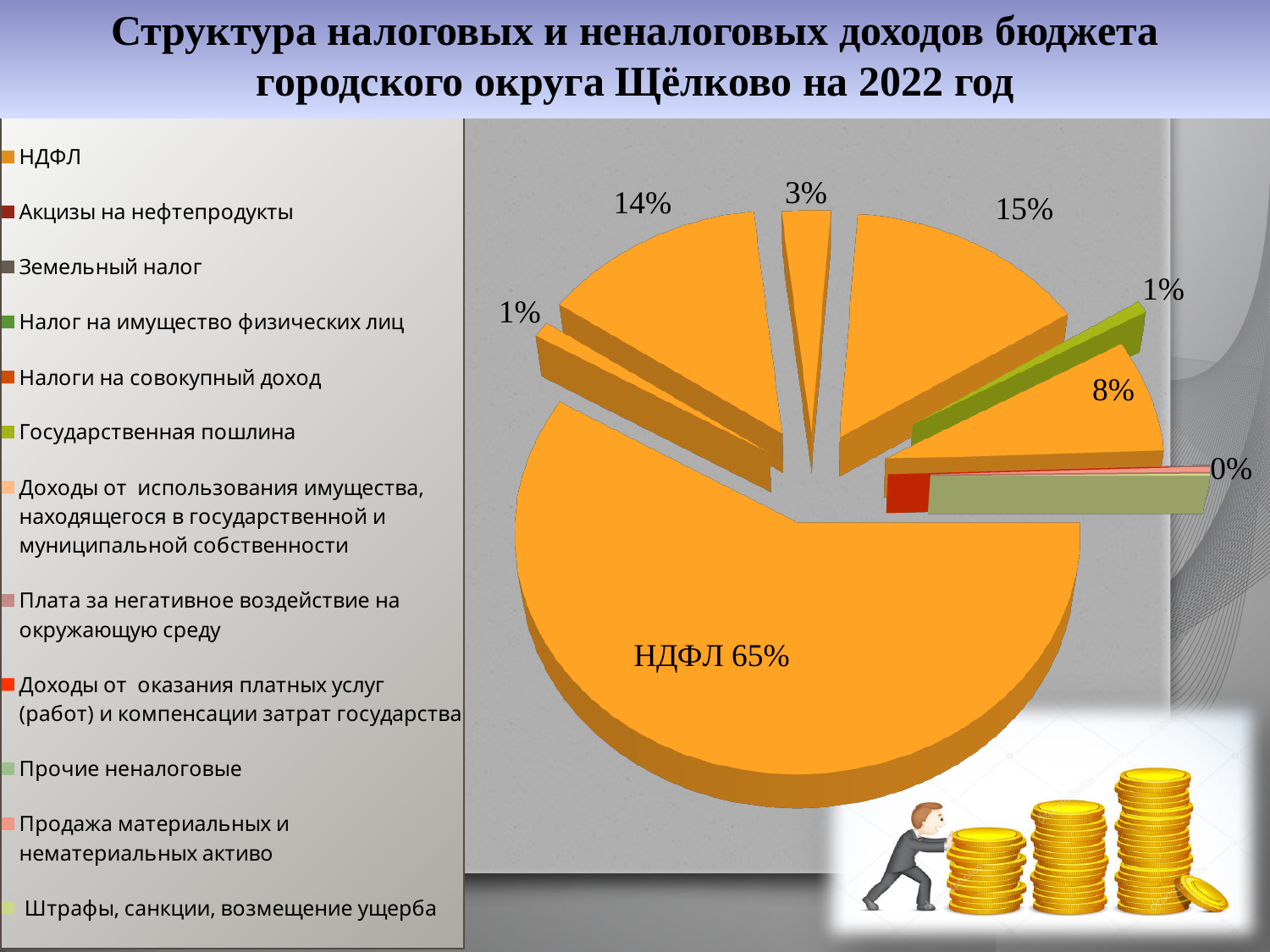
Which entry appears first in the legend of the pie chart? НДФЛ Is the share of НДФЛ greater or less than 50%? greater What percentage is printed on the largest slice of the pie? 65% How many entries does the legend of the pie chart list? 12 Which category has the largest slice of the pie? НДФЛ Which is larger: the НДФЛ slice or the slice labelled 14%? НДФЛ What kind of chart is shown on the slide? Pie chart What is the difference in percentage points between the НДФЛ slice (65%) and the slice labelled 15%? 50 How many percentage labels are printed around the pie chart? 8 What is the title of the chart on the slide? Структура налоговых и неналоговых доходов бюджета городского округа Щёлково на 2022 год What is the smallest percentage value printed on the pie chart? 0% What share of the pie does НДФЛ take? 65%